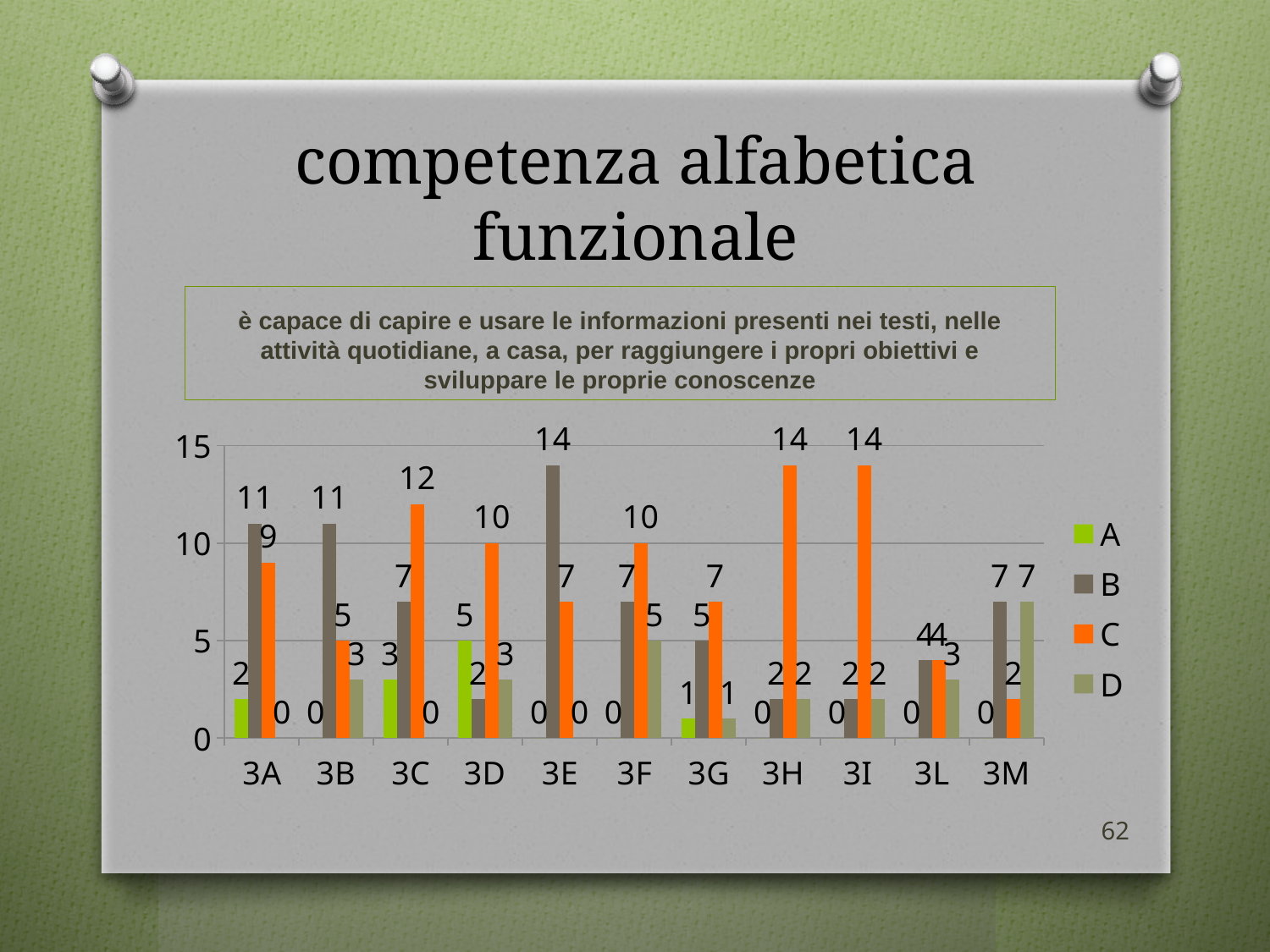
What is the value of series D for 3F? 5 What is the value of series A for 3D? 5 What is the value of series B for 3E? 14 How many series does the legend list? 4 Which category has the highest value for series A? 3D Which is larger for 3F, series B or series C? C What is the title of the slide containing the chart? competenza alfabetica funzionale What is the value of series C for 3C? 12 How many categories are shown on the x axis? 11 What kind of chart is shown on the slide? bar chart What is the difference between series B and series C for 3A? 2 Which category has the highest value for series C? 3H and 3I